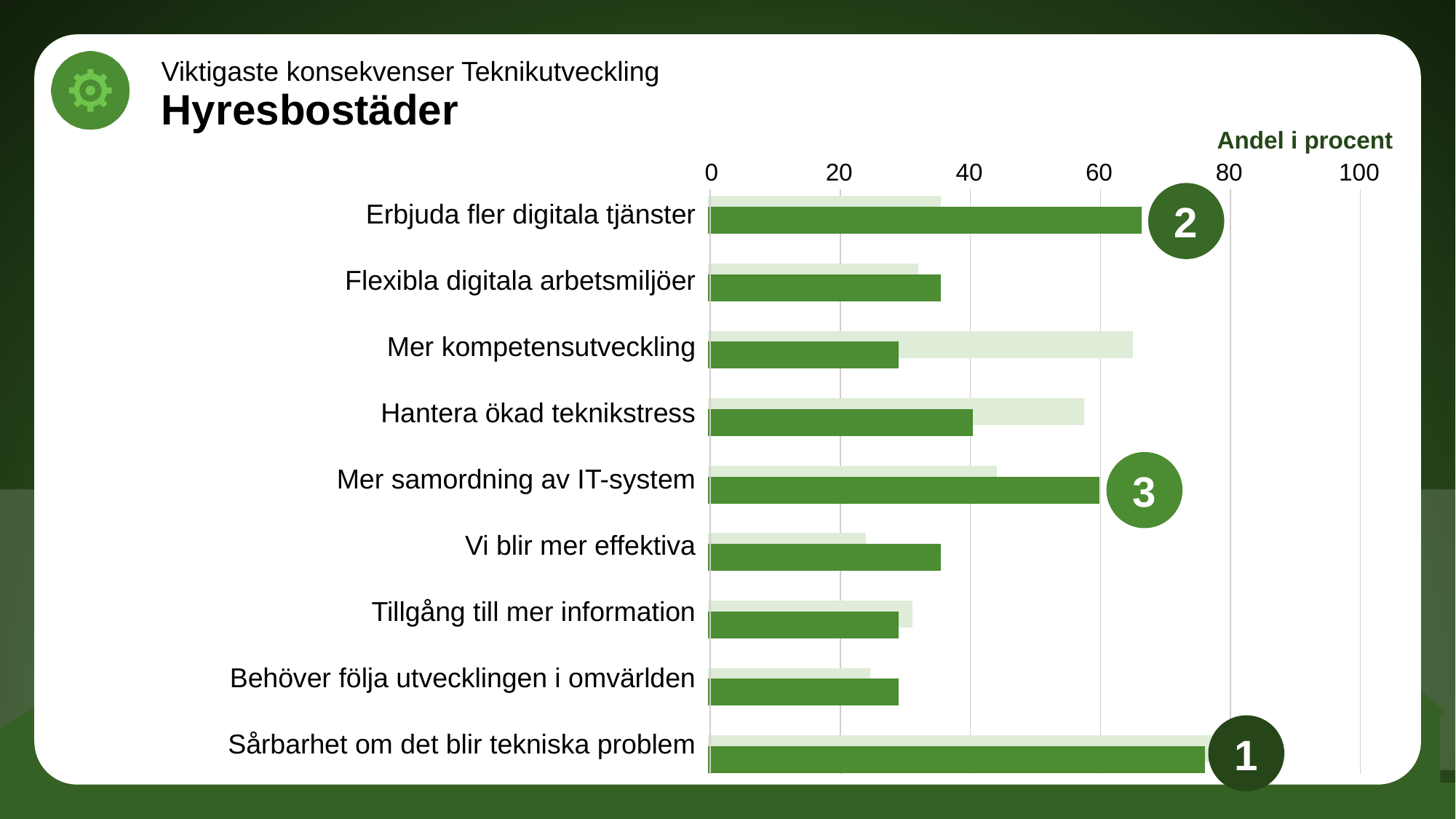
Is the light green value for Mer kompetensutveckling greater or less than 60? greater Is the light green value for Vi blir mer effektiva greater or less than 40? less Is the dark green value for Mer kompetensutveckling greater or less than 40? less Which has the larger light green value: Hantera ökad teknikstress or Vi blir mer effektiva? Hantera ökad teknikstress Which category has the longest dark green bar? Sårbarhet om det blir tekniska problem How many categories are listed on the chart? 9 What kind of chart is shown on the slide? bar chart Which has the larger dark green value: Mer samordning av IT-system or Hantera ökad teknikstress? Mer samordning av IT-system Which category has the longest light green bar? Sårbarhet om det blir tekniska problem What is the label shown above the horizontal axis of the chart? Andel i procent